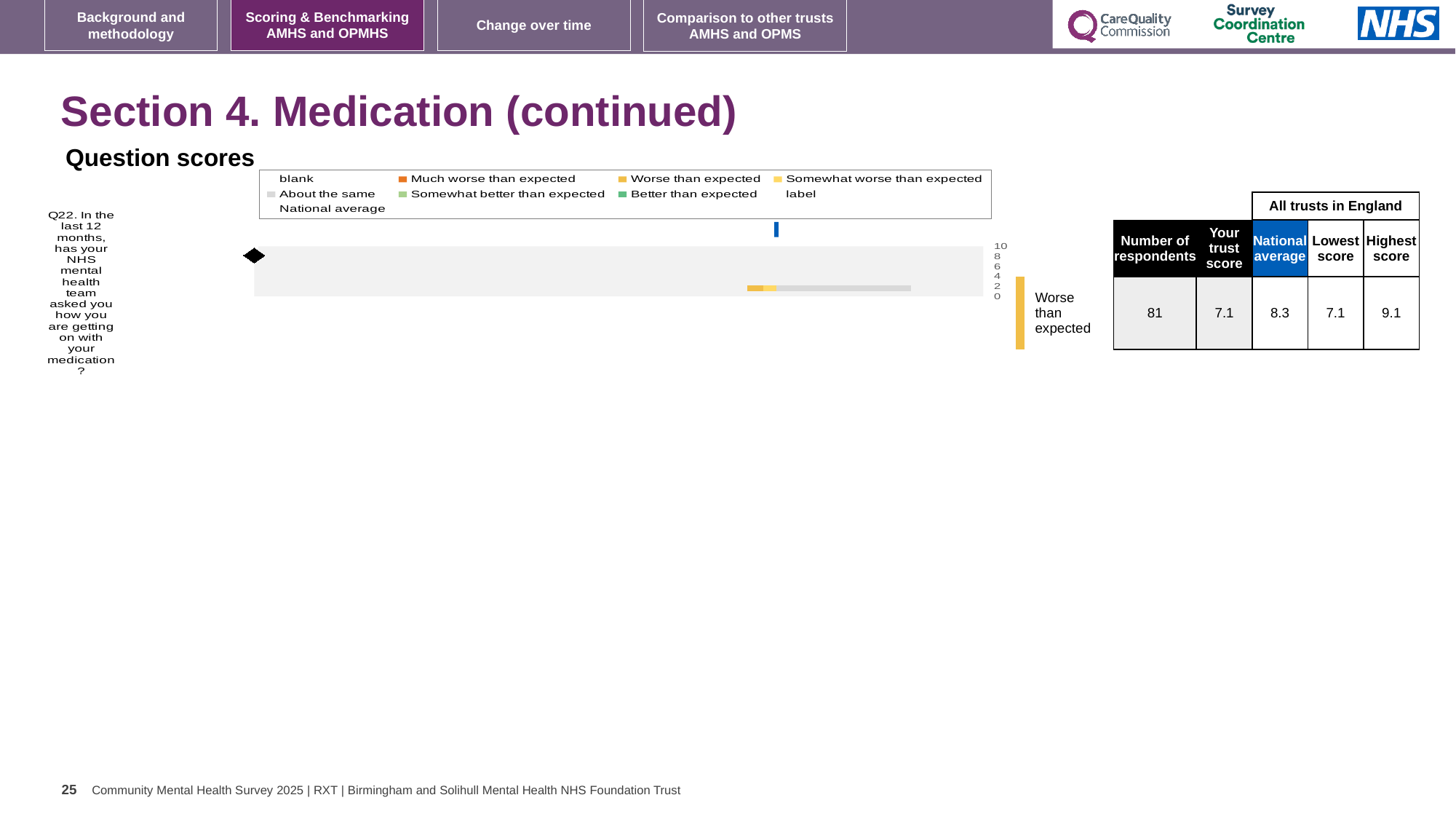
What benchmark category is shown for Q22 in the 'Question scores' chart? Worse than expected How many questions are plotted in the 'Question scores' chart? 1 For Q22, what is the difference between the national average and your trust score? 1.2 For Q22, what is the difference between the highest score and the lowest score among all trusts in England? 2.0 In the table next to the 'Question scores' chart, what is the national average for Q22? 8.3 Which question is plotted in the 'Question scores' chart? Q22. In the last 12 months, has your NHS mental health team asked you how you are getting on with your medication? What kind of chart is shown under 'Question scores'? bar chart For Q22, which is larger: your trust score or the national average? national average In the table next to the 'Question scores' chart, what is your trust score for Q22? 7.1 In the table next to the 'Question scores' chart, what is the lowest score among all trusts in England for Q22? 7.1 In the table next to the 'Question scores' chart, what is the highest score among all trusts in England for Q22? 9.1 In the table next to the 'Question scores' chart, what is the number of respondents for Q22? 81